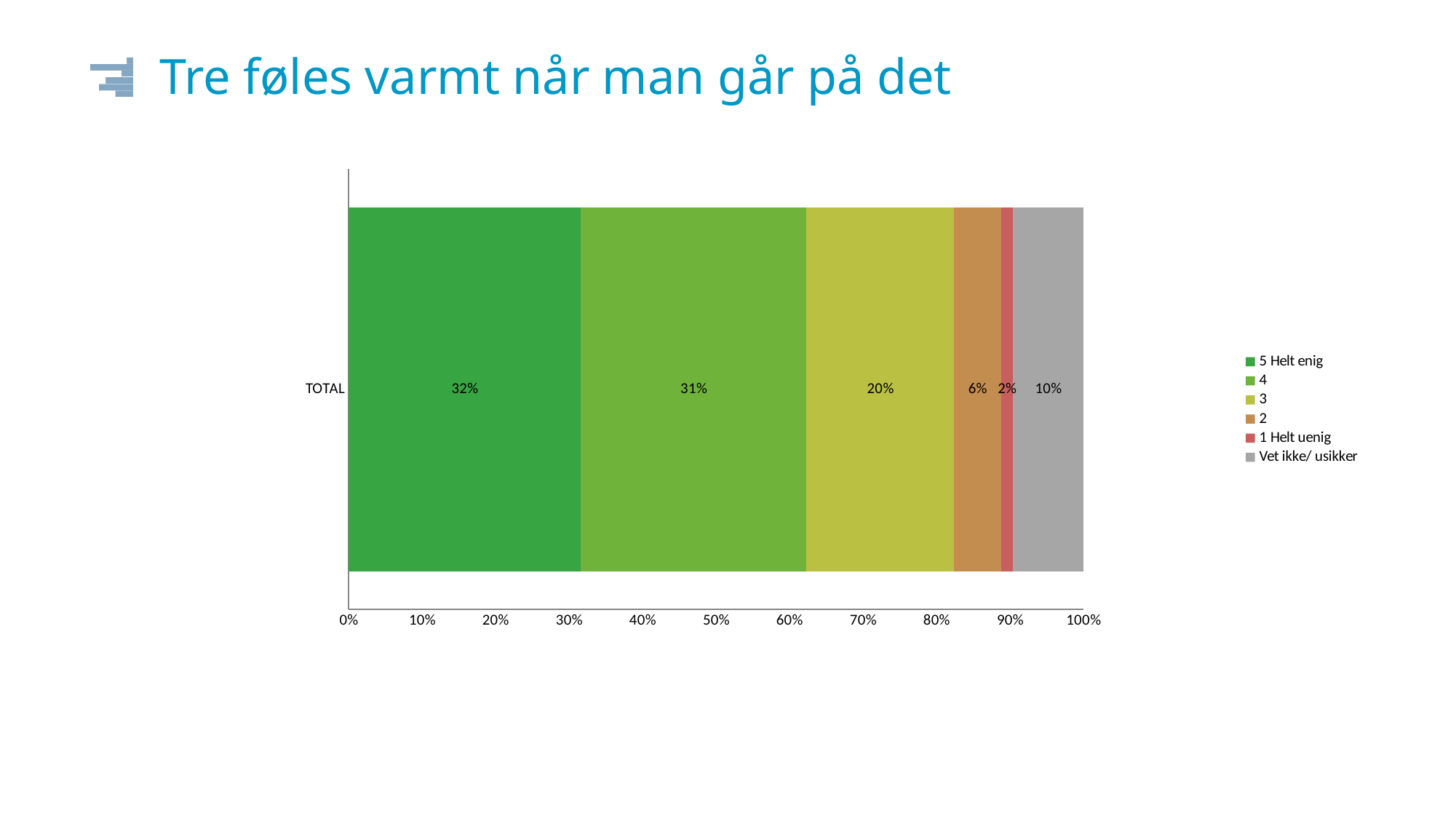
What percentage of respondents answered '3'? 20% What percentage of respondents answered '2'? 6% What percentage of respondents answered '5 Helt enig'? 32% What percentage of respondents answered '4'? 31% What percentage of respondents answered '1 Helt uenig'? 2% What kind of chart is shown on the slide? Stacked bar chart What percentage of respondents answered 'Vet ikke/ usikker'? 10% Which response category has the smallest share? 1 Helt uenig How many series does the legend list? 6 Which is larger, the share for 'Vet ikke/ usikker' or the share for '2'? Vet ikke/ usikker Which response category has the largest share? 5 Helt enig What is the difference between the share for '3' and the share for '2'? 14%